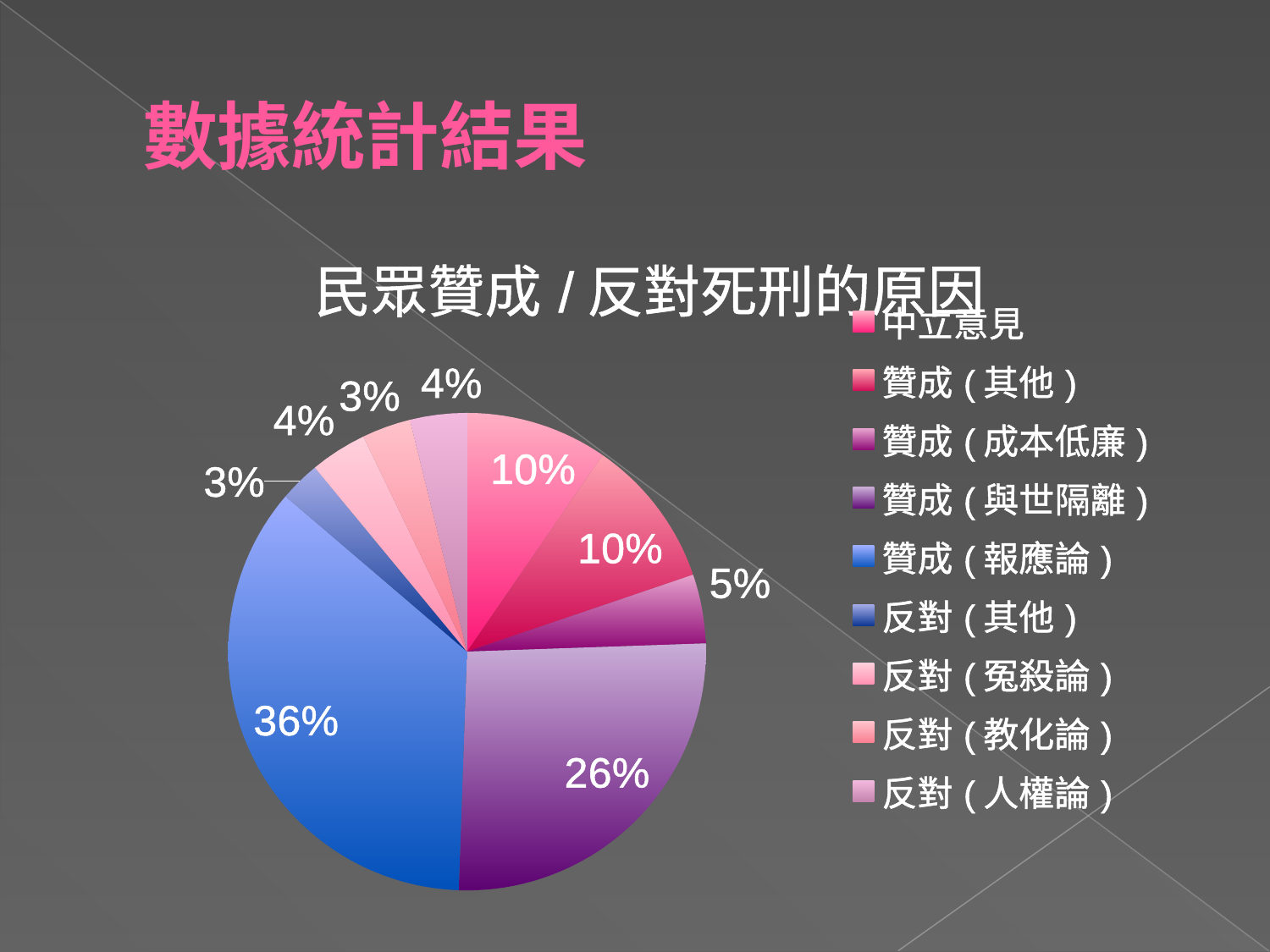
What share of the pie is 反對 ( 冤殺論 )? 4% Which is larger, the share for 贊成 ( 與世隔離 ) or the share for 中立意見? 贊成 ( 與世隔離 ) What type of chart is shown on the slide? pie chart What is the title of the chart? 民眾贊成 / 反對死刑的原因 What is the combined share of 中立意見 and 贊成 ( 其他 )? 20% How many categories does the legend list? 9 What is the difference in percentage points between 贊成 ( 報應論 ) and 贊成 ( 與世隔離 )? 10 What share of the pie is 贊成 ( 與世隔離 )? 26% What share of the pie is 贊成 ( 報應論 )? 36% What share of the pie is 中立意見? 10% What share of the pie is 贊成 ( 成本低廉 )? 5% Which category has the largest share of the pie? 贊成 ( 報應論 )